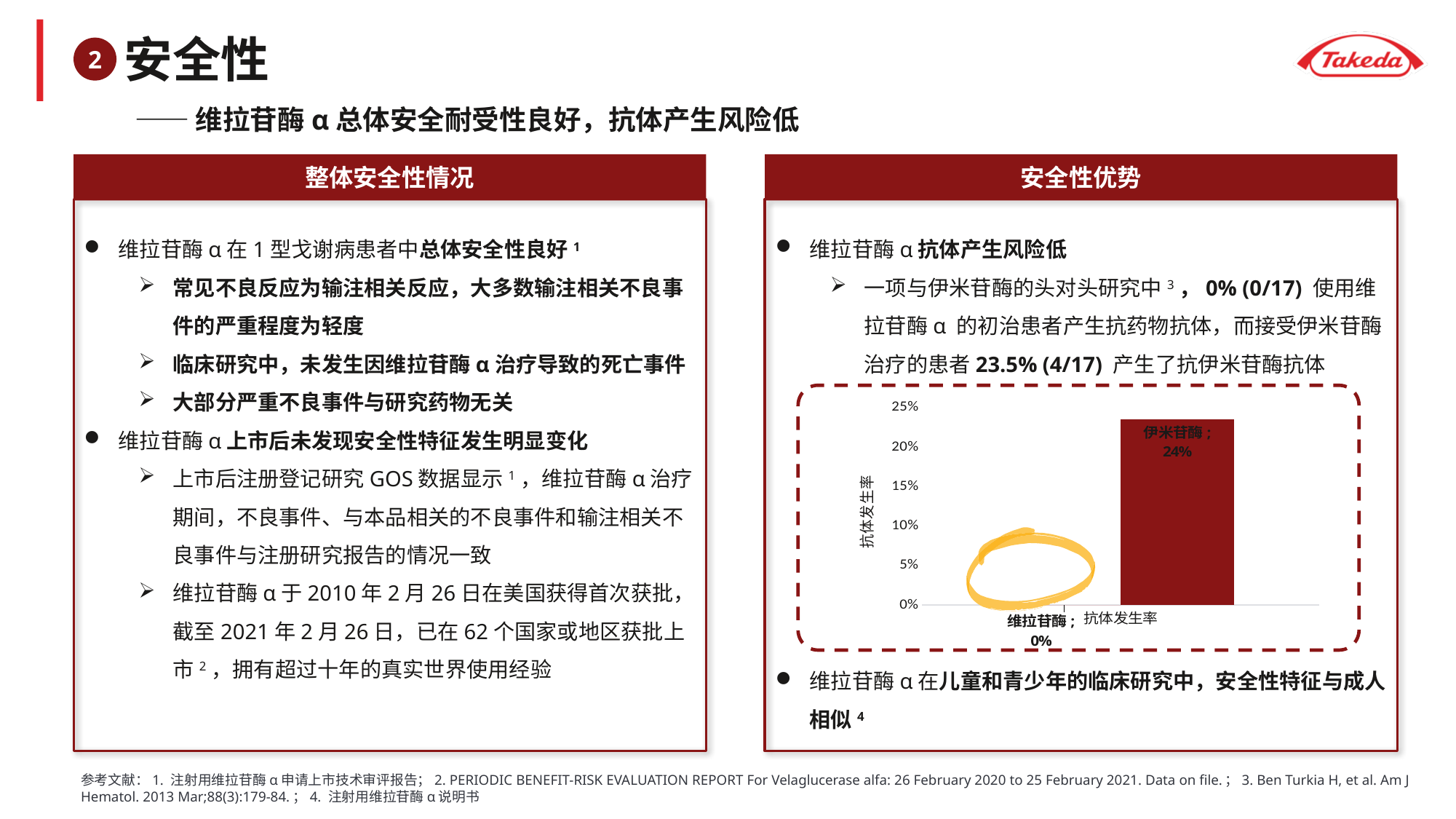
Which category has the higher antibody incidence rate in the chart? 伊米苷酶 Is the antibody incidence rate for 伊米苷酶 greater or less than 25%? less How many categories are plotted in the chart? 2 What is the label of the vertical axis of the chart? 抗体发生率 What is the maximum value shown on the vertical axis of the chart? 25% What kind of chart is shown on the slide? Bar chart What is the antibody incidence rate (抗体发生率) shown for 伊米苷酶 in the chart? 24% Is the antibody incidence rate for 伊米苷酶 greater or less than 20%? greater Which category has the lowest antibody incidence rate in the chart? 维拉苷酶 What is the difference in antibody incidence rate between 伊米苷酶 and 维拉苷酶 in the chart? 24% What is the antibody incidence rate (抗体发生率) shown for 维拉苷酶 in the chart? 0%